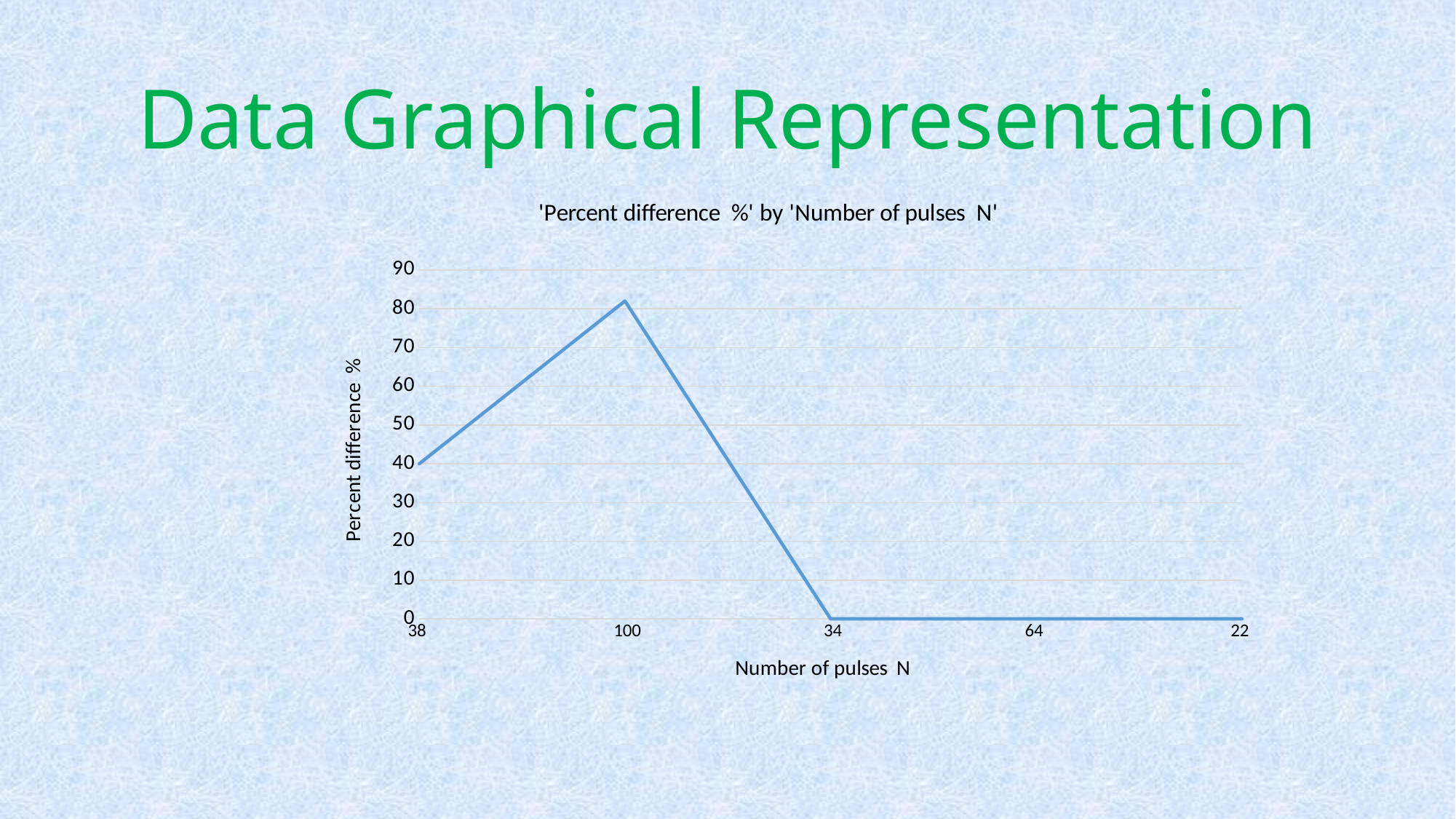
What is the percent difference for number of pulses 64? 0 Which has a larger percent difference, number of pulses 38 or 100? 100 Which number of pulses N has the highest percent difference? 100 What is the percent difference for number of pulses 34? 0 Does the percent difference rise or fall between number of pulses 100 and 34? fall What is the title of the chart? 'Percent difference %' by 'Number of pulses N' What is the percent difference for number of pulses 22? 0 What is the label of the x axis? Number of pulses N What kind of chart is shown on the slide? line chart How many points are plotted along the x axis of the chart? 5 Is the percent difference for number of pulses 100 greater or less than 70? greater Is the percent difference for number of pulses 38 greater or less than 50? less